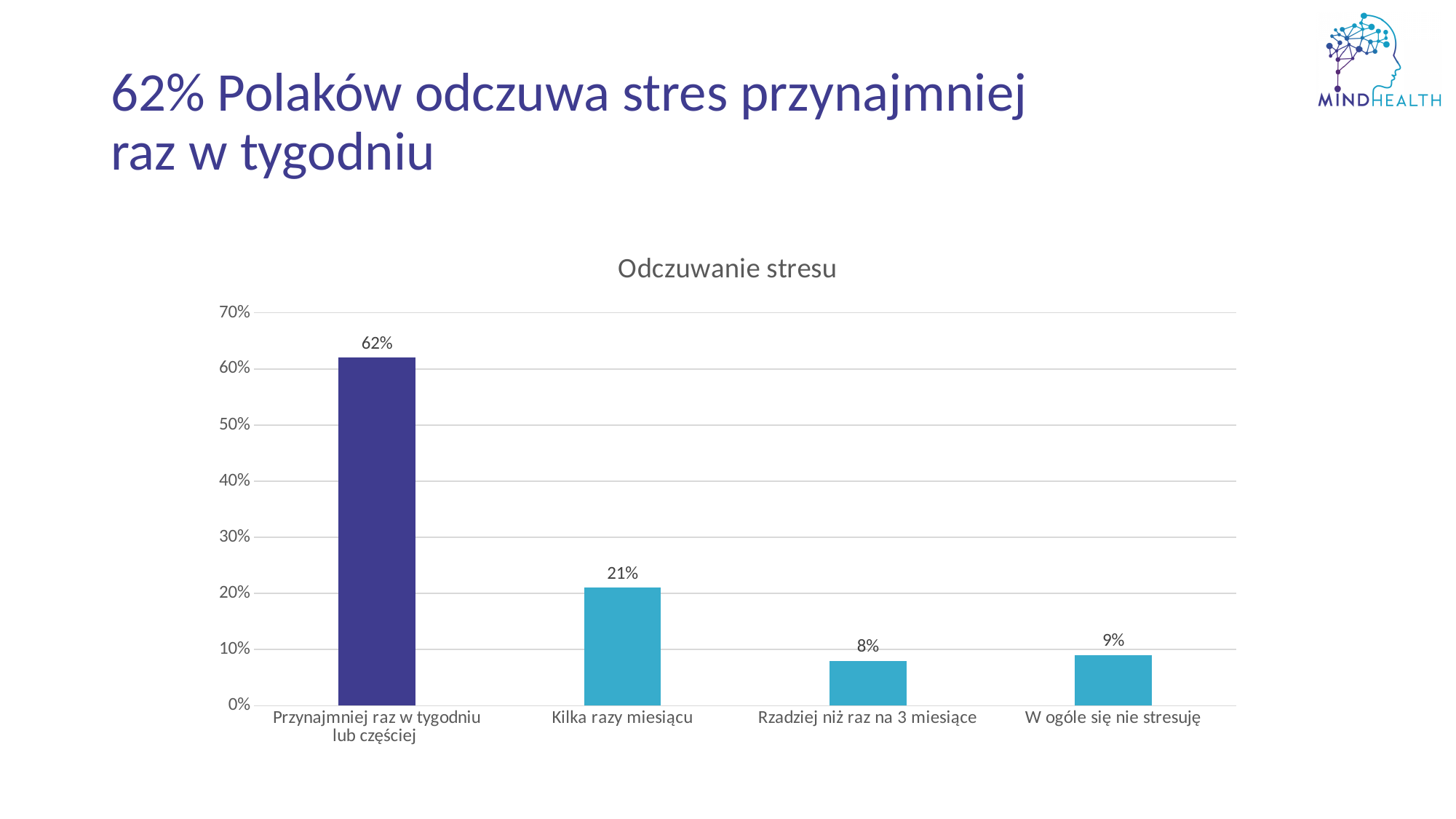
How many categories are shown on the chart? 4 Which category has the lowest value? Rzadziej niż raz na 3 miesiące What is the value for "Kilka razy miesiącu"? 21% Which is larger, the value for "Kilka razy miesiącu" or the value for "W ogóle się nie stresuję"? Kilka razy miesiącu What is the difference between the values for "Przynajmniej raz w tygodniu lub częściej" and "Kilka razy miesiącu"? 41% What is the value for "Przynajmniej raz w tygodniu lub częściej"? 62% What is the value for "W ogóle się nie stresuję"? 9% What is the value for "Rzadziej niż raz na 3 miesiące"? 8% What is the title of the chart? Odczuwanie stresu What kind of chart is shown on the slide? bar chart Is the value for "Kilka razy miesiącu" greater or less than 30%? less Which category has the highest value? Przynajmniej raz w tygodniu lub częściej